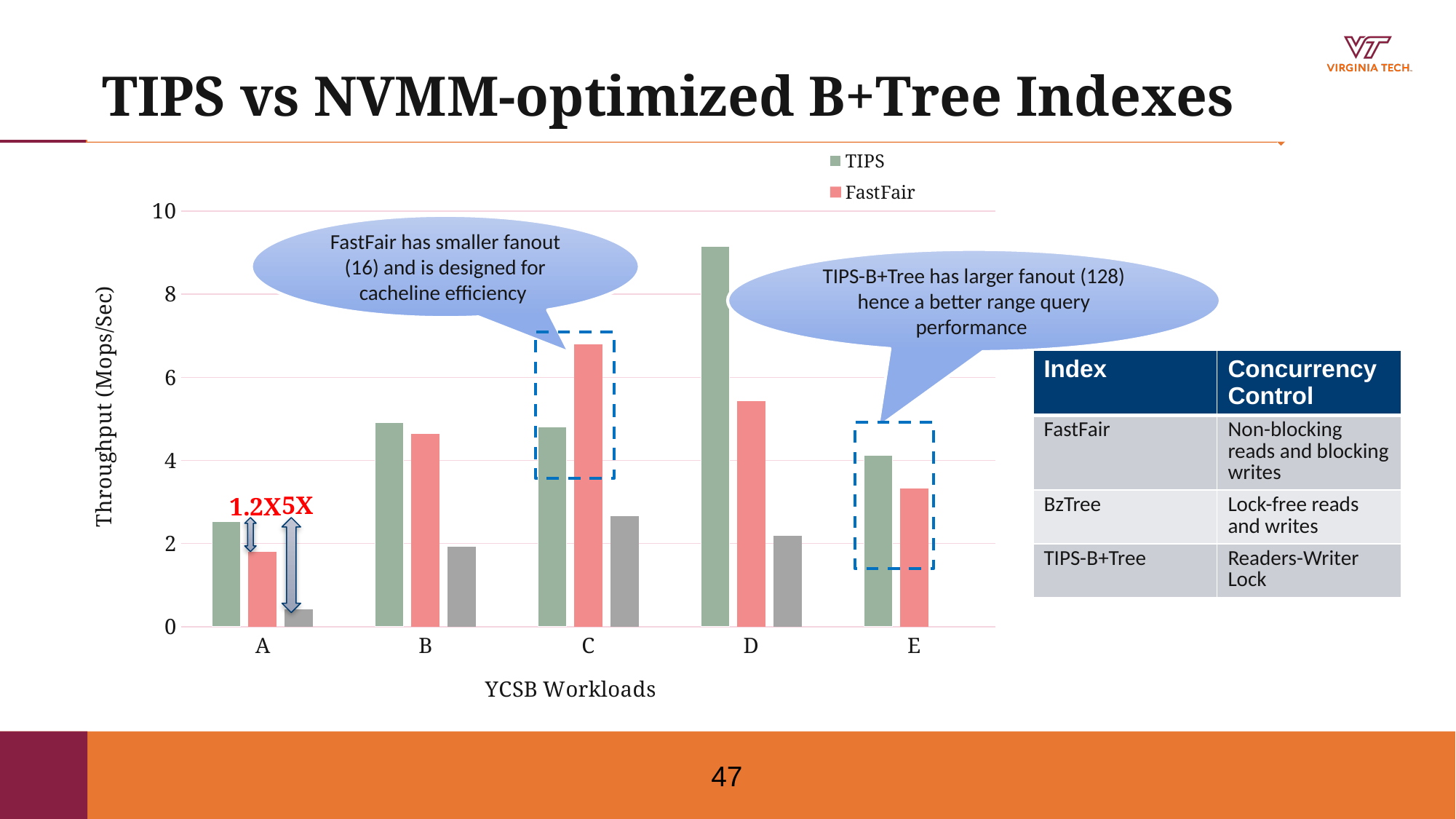
Is the FastFair value for workload C greater or less than 6? greater How many series does the legend list? 2 Is the TIPS value for workload A greater or less than 4? less What is the label of the y axis? Throughput (Mops/Sec) What is the label of the x axis? YCSB Workloads For which workload is the TIPS throughput lowest? A For workload C, which series has the higher throughput, TIPS or FastFair? FastFair Is the TIPS value for workload D greater or less than 8? greater For workload D, which series has the higher throughput, TIPS or FastFair? TIPS What kind of chart is shown on the slide? Bar chart For which workload is the TIPS throughput highest? D How many YCSB workload categories are shown on the x axis? 5